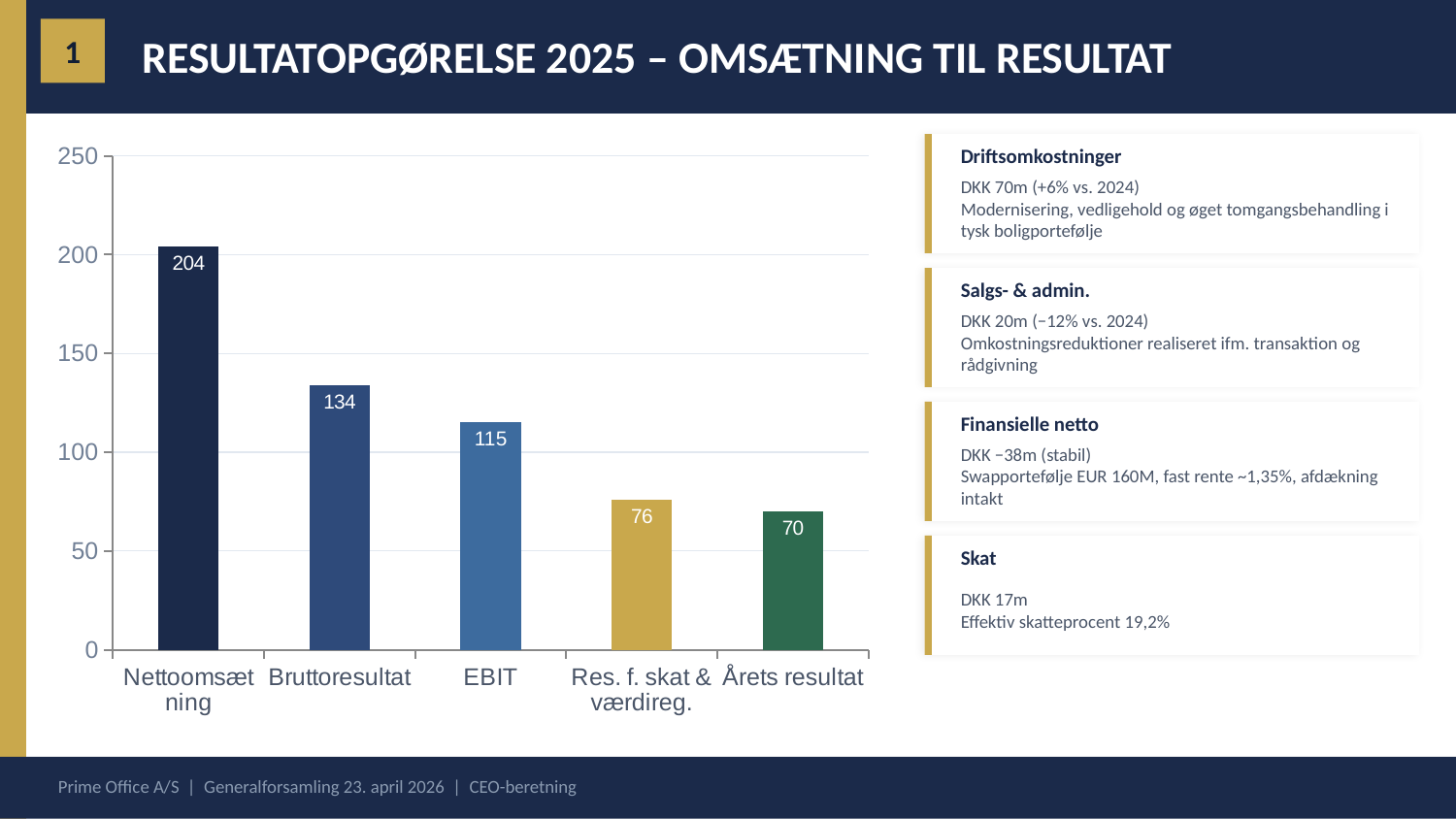
What is the value for Årets resultat? 70 Which category has the lowest value? Årets resultat Do the values rise or fall from left to right along the x axis? Fall What is the value for Nettoomsætning? 204 What is the difference between EBIT and Årets resultat? 45 What is the value for Res. f. skat & værdireg.? 76 How many categories are shown on the x axis? 5 Which is larger, Bruttoresultat or EBIT? Bruttoresultat What is the value for EBIT? 115 What kind of chart is shown on the slide? Bar chart Which category has the highest value? Nettoomsætning What is the difference between Nettoomsætning and Bruttoresultat? 70